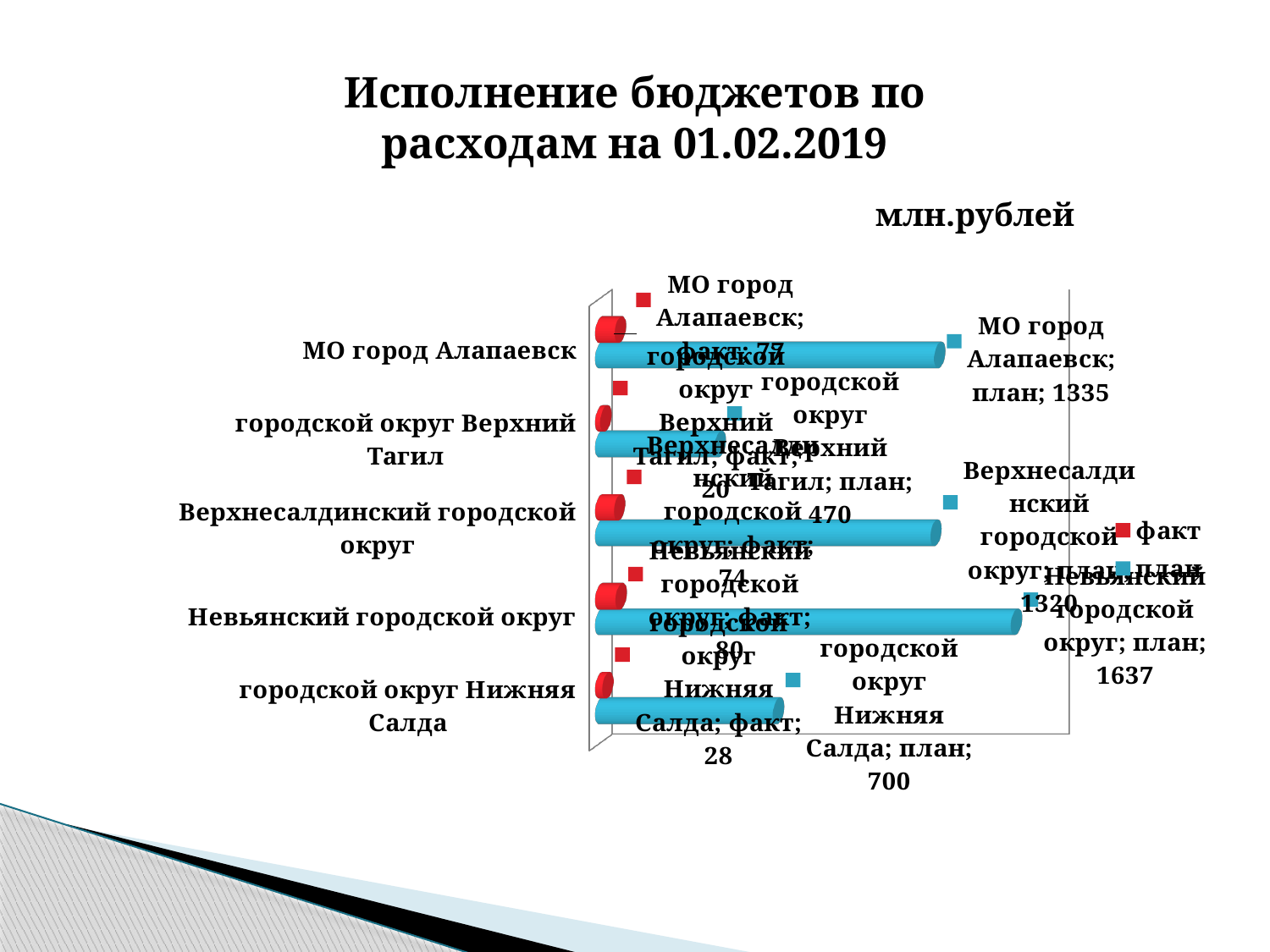
What unit of measurement is stated above the chart? млн.рублей Which is larger: the план value for Верхнесалдинский городской округ or for городской округ Нижняя Салда? Верхнесалдинский городской округ What is the план value for МО город Алапаевск? 1335 How many municipalities (categories) are shown in the chart? 5 What kind of chart is shown on the slide? bar chart Which municipality has the lowest план value? городской округ Верхний Тагил What is the план value for городской округ Нижняя Салда? 700 What is the факт value for городской округ Верхний Тагил? 20 What is the difference between the план values of Невьянский городской округ and МО город Алапаевск? 302 How many series does the legend list? 2 What is the план value for Невьянский городской округ? 1637 Which municipality has the highest план value? Невьянский городской округ